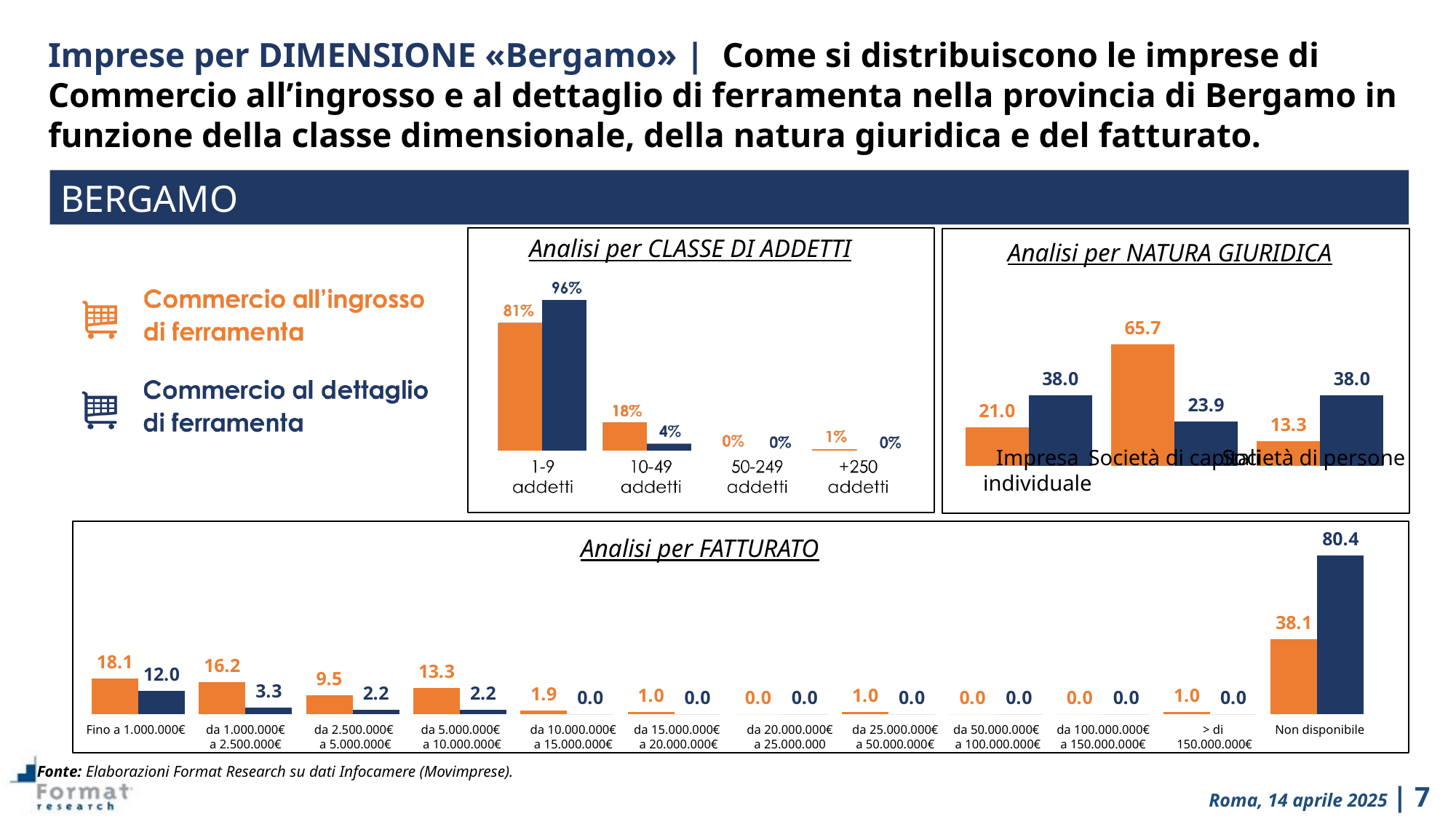
What type of chart is 'Analisi per NATURA GIURIDICA'? Bar chart In the 'Analisi per FATTURATO' chart, what is the difference between the two series in the 'da 1.000.000€ a 2.500.000€' category? 12.9 In the 'Analisi per NATURA GIURIDICA' chart, which category has the lowest value for Commercio all'ingrosso di ferramenta? Società di persone In the 'Analisi per CLASSE DI ADDETTI' chart, what is the value for Commercio all'ingrosso di ferramenta in the 10-49 addetti category? 18% How many series does the legend on the slide list? 2 In the 'Analisi per FATTURATO' chart, what is the value for Commercio all'ingrosso di ferramenta in the 'Fino a 1.000.000€' category? 18.1 In the 'Analisi per CLASSE DI ADDETTI' chart, what is the value for Commercio al dettaglio di ferramenta in the 1-9 addetti category? 96% In the 'Analisi per CLASSE DI ADDETTI' chart, what is the difference between the two series in the 1-9 addetti category? 15 percentage points How many revenue categories are shown in the 'Analisi per FATTURATO' chart? 12 In the 'Analisi per FATTURATO' chart, what is the value for Commercio al dettaglio di ferramenta in the Non disponibile category? 80.4 In the 'Analisi per NATURA GIURIDICA' chart, what is the value for Commercio all'ingrosso di ferramenta for Società di capitali? 65.7 In the 'Analisi per NATURA GIURIDICA' chart, which is larger for Impresa individuale: Commercio all'ingrosso or Commercio al dettaglio? Commercio al dettaglio